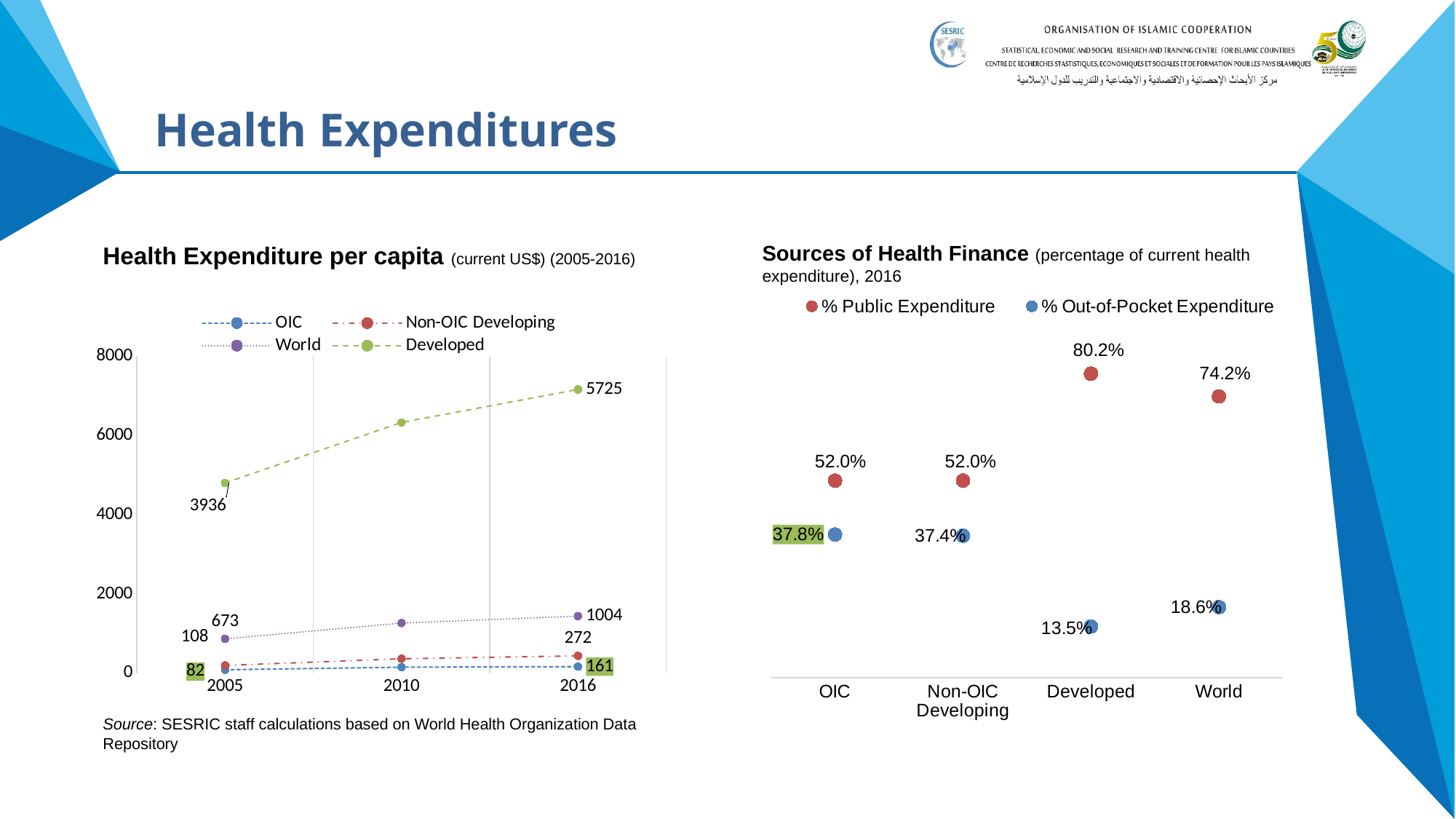
In the Health Expenditure per capita chart, what is the value for Developed in 2016? 5725 In the Health Expenditure per capita chart, by how much did the OIC value increase from 2005 to 2016? 79 In the Health Expenditure per capita chart, does the Developed series rise or fall from 2005 to 2016? Rise In the Health Expenditure per capita chart, what is the value for OIC in 2005? 82 What kind of chart is the Health Expenditure per capita chart? Line chart In the Sources of Health Finance chart, what is the % Out-of-Pocket Expenditure for World? 18.6% In the Sources of Health Finance chart, which group has the highest % Public Expenditure? Developed In the Health Expenditure per capita chart, what is the value for Non-OIC Developing in 2016? 272 In the Sources of Health Finance chart, which group has the lowest % Out-of-Pocket Expenditure? Developed In the Health Expenditure per capita chart, is the World value in 2010 greater or less than 2000? less In the Health Expenditure per capita chart, how many series does the legend list? 4 In the Health Expenditure per capita chart, how many years are shown on the x axis? 3